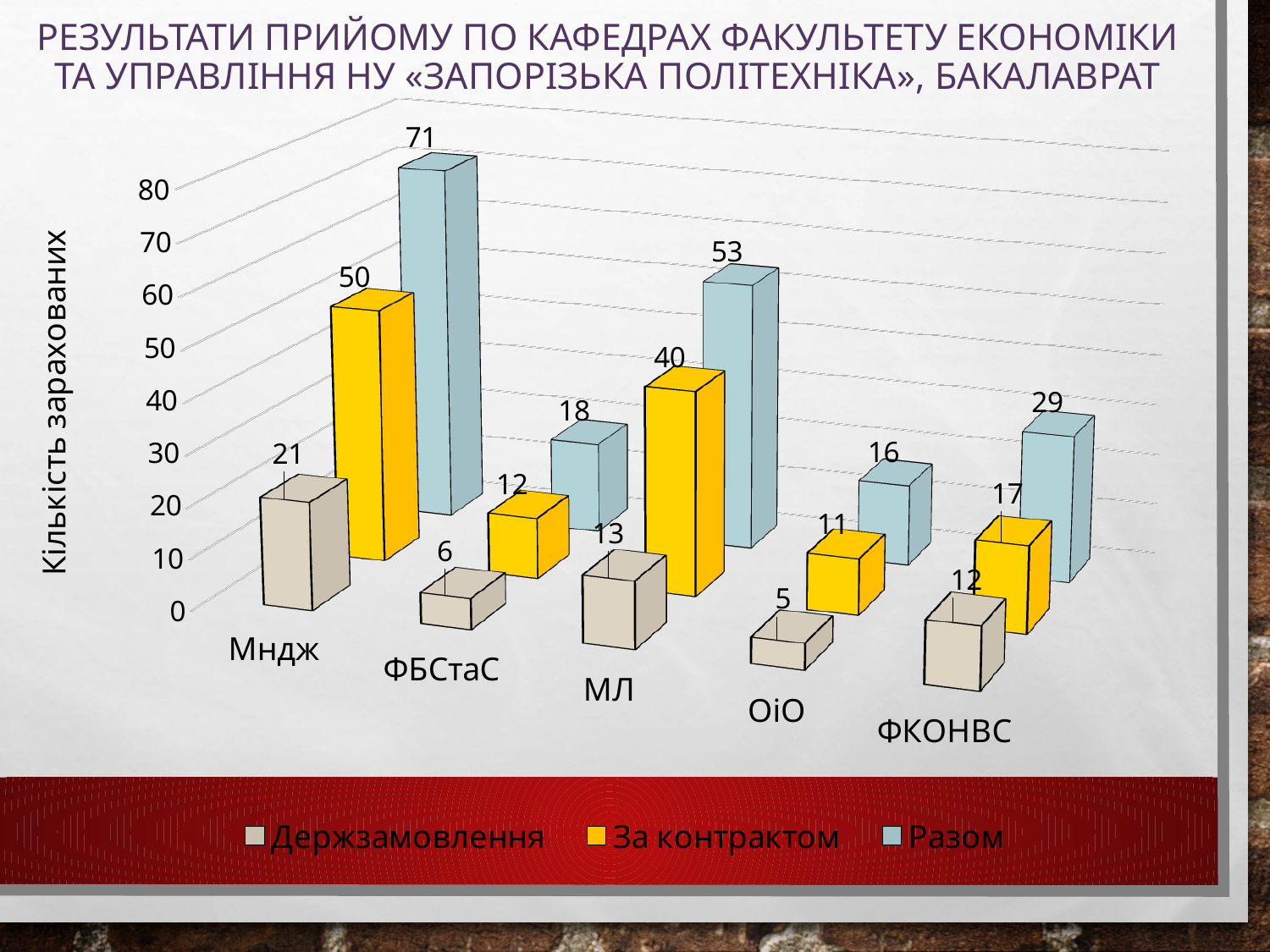
Which category has the highest Разом value? Мндж What is the value of Разом for Мндж? 71 What is the difference between the Разом values for Мндж and МЛ? 18 What is the value of За контрактом for ФКОНВС? 17 How many series does the legend list? 3 How many categories (departments) are shown on the x axis? 5 What is the value of Держзамовлення for ОіО? 5 What is the value of За контрактом for МЛ? 40 What kind of chart is shown on the slide? bar chart Which is larger: За контрактом for ФБСтаС or За контрактом for ФКОНВС? ФКОНВС What is the label of the vertical axis? Кількість зарахованих Which category has the lowest Держзамовлення value? ОіО